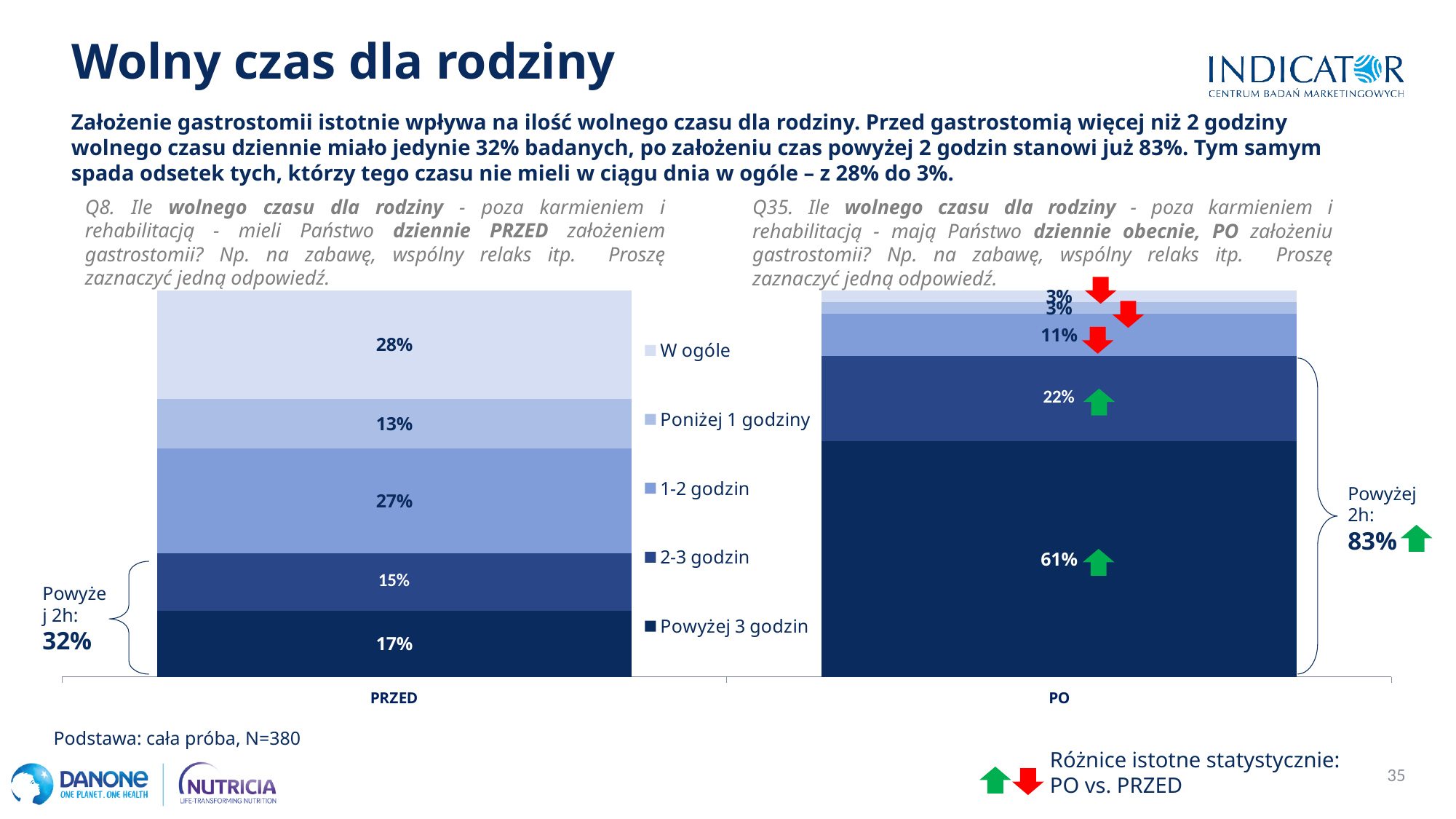
What is the difference between the 'Powyżej 3 godzin' values for PO and PRZED? 44% What is the value for 'W ogóle' in the PRZED bar? 28% What kind of chart is shown on the slide? stacked bar chart How many series does the legend list? 5 Which segment is the smallest in the PRZED bar? Poniżej 1 godziny What are the x-axis category labels of the chart? PRZED and PO Which segment is the largest in the PO bar? Powyżej 3 godzin How many bars (categories) are plotted on the x axis? 2 What is the value for '1-2 godzin' in the PRZED bar? 27% Which is larger: the 'W ogóle' value for PRZED or for PO? PRZED What is the value for 'Powyżej 3 godzin' in the PO bar? 61% What is the value for '2-3 godzin' in the PO bar? 22%